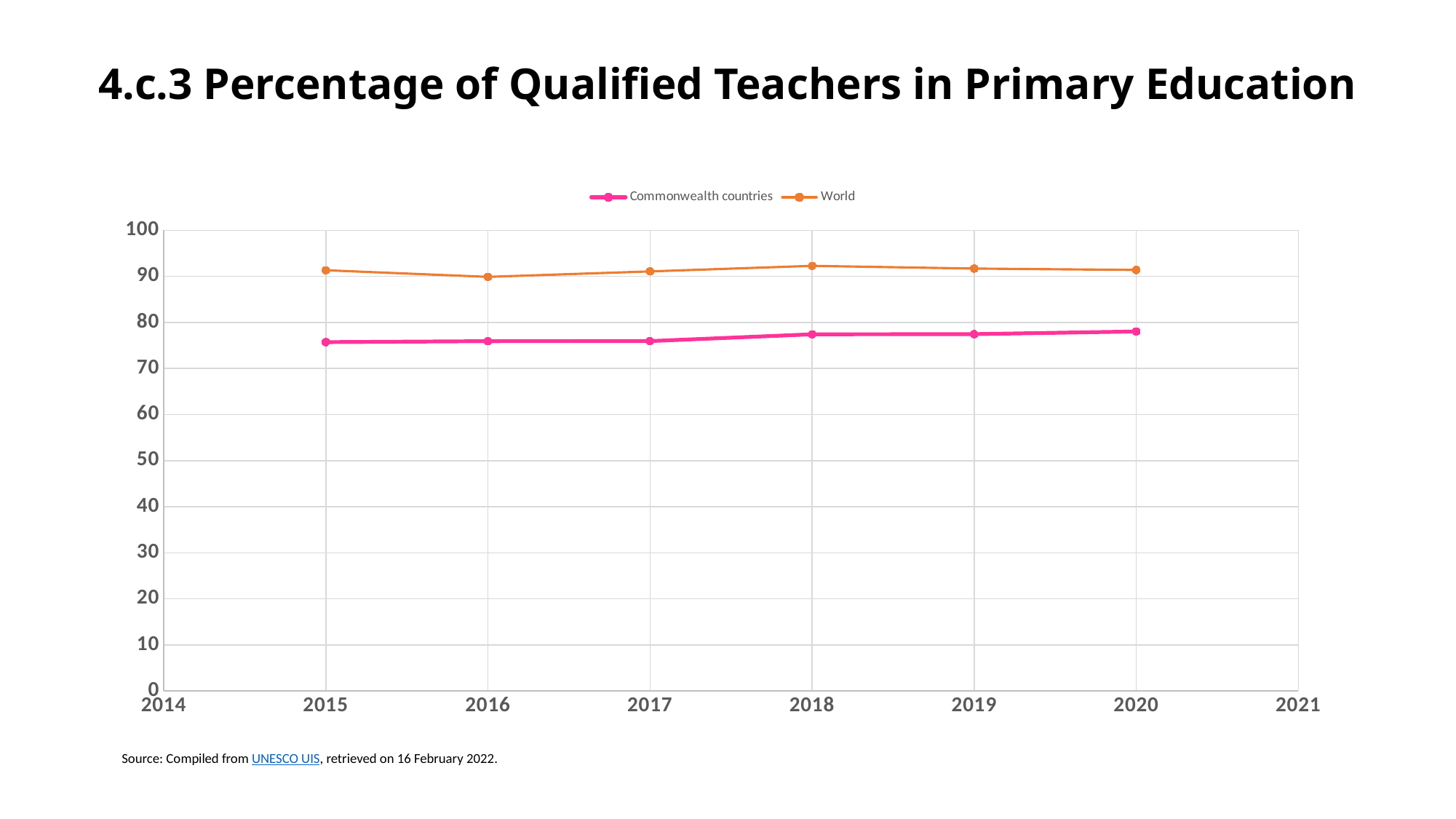
In which year is the World series at its lowest? 2016 How many series does the legend list? 2 Which series has the higher value in 2019, Commonwealth countries or World? World Which colour represents the Commonwealth countries series? pink Is the value for Commonwealth countries in 2015 greater or less than 80? less Is the value for World in 2018 greater or less than 90? greater Is the value for Commonwealth countries in 2020 greater or less than 70? greater What type of chart is shown on the slide? line chart How many data points are plotted for the World series? 6 Does the Commonwealth countries series generally rise or fall from 2015 to 2020? rise What is the title of the chart? 4.c.3 Percentage of Qualified Teachers in Primary Education